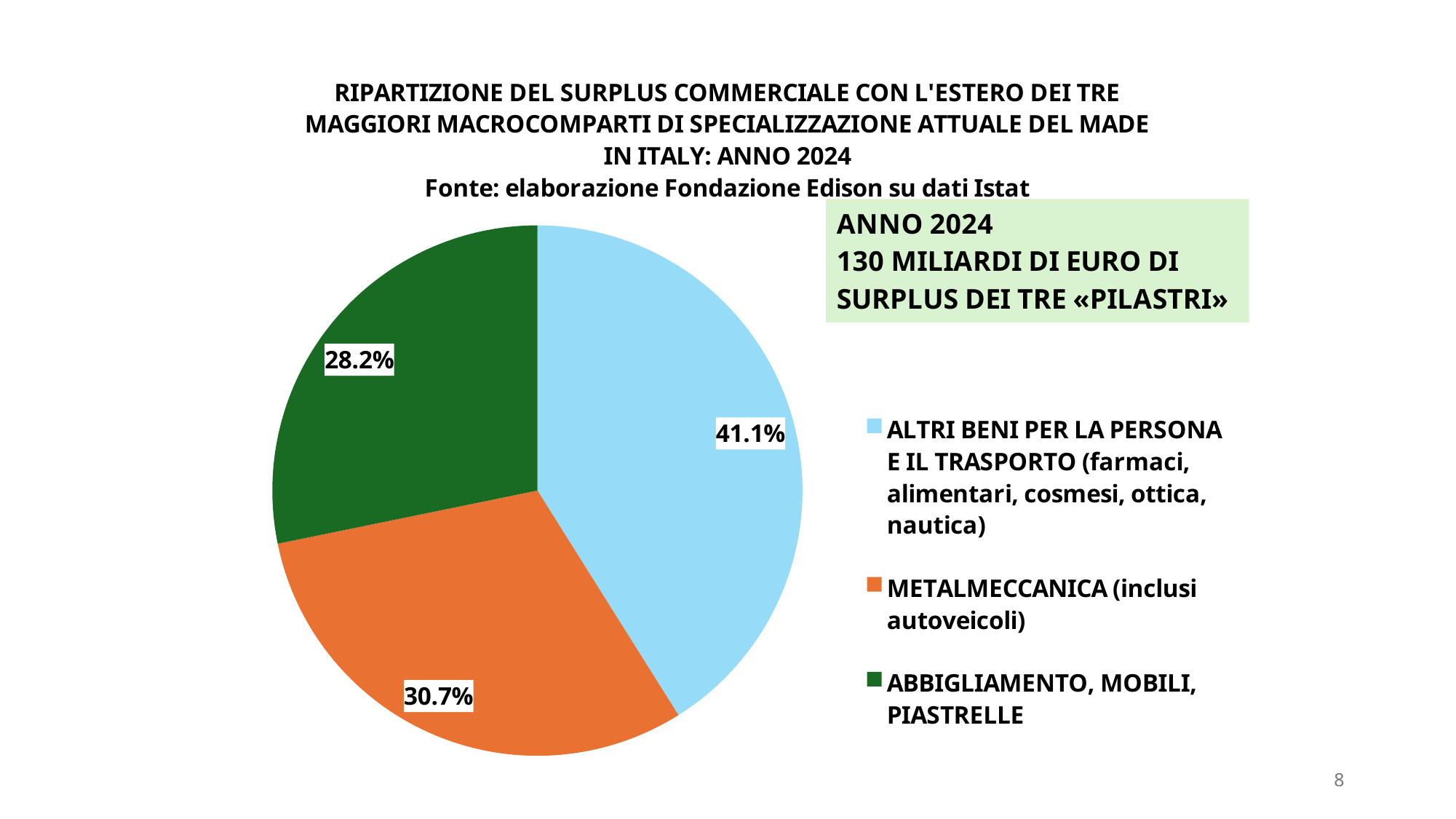
What share of the surplus does ABBIGLIAMENTO, MOBILI, PIASTRELLE account for? 28.2% What share of the surplus does METALMECCANICA (inclusi autoveicoli) account for? 30.7% What is the difference in percentage points between the share of METALMECCANICA and the share of ABBIGLIAMENTO, MOBILI, PIASTRELLE? 2.5 percentage points Which category has the smallest share of the pie? ABBIGLIAMENTO, MOBILI, PIASTRELLE What share of the surplus does ALTRI BENI PER LA PERSONA E IL TRASPORTO account for? 41.1% What is the difference in percentage points between the share of ALTRI BENI PER LA PERSONA E IL TRASPORTO and the share of METALMECCANICA? 10.4 percentage points What colour is the slice for METALMECCANICA (inclusi autoveicoli)? Orange What type of chart is shown on the slide? Pie chart According to the text box on the slide, what is the total surplus of the three 'pilastri' in 2024? 130 miliardi di euro How many slices does the pie chart have? 3 Which has a larger share: METALMECCANICA or ABBIGLIAMENTO, MOBILI, PIASTRELLE? METALMECCANICA (inclusi autoveicoli) Which category has the largest share of the pie? ALTRI BENI PER LA PERSONA E IL TRASPORTO (farmaci, alimentari, cosmesi, ottica, nautica)